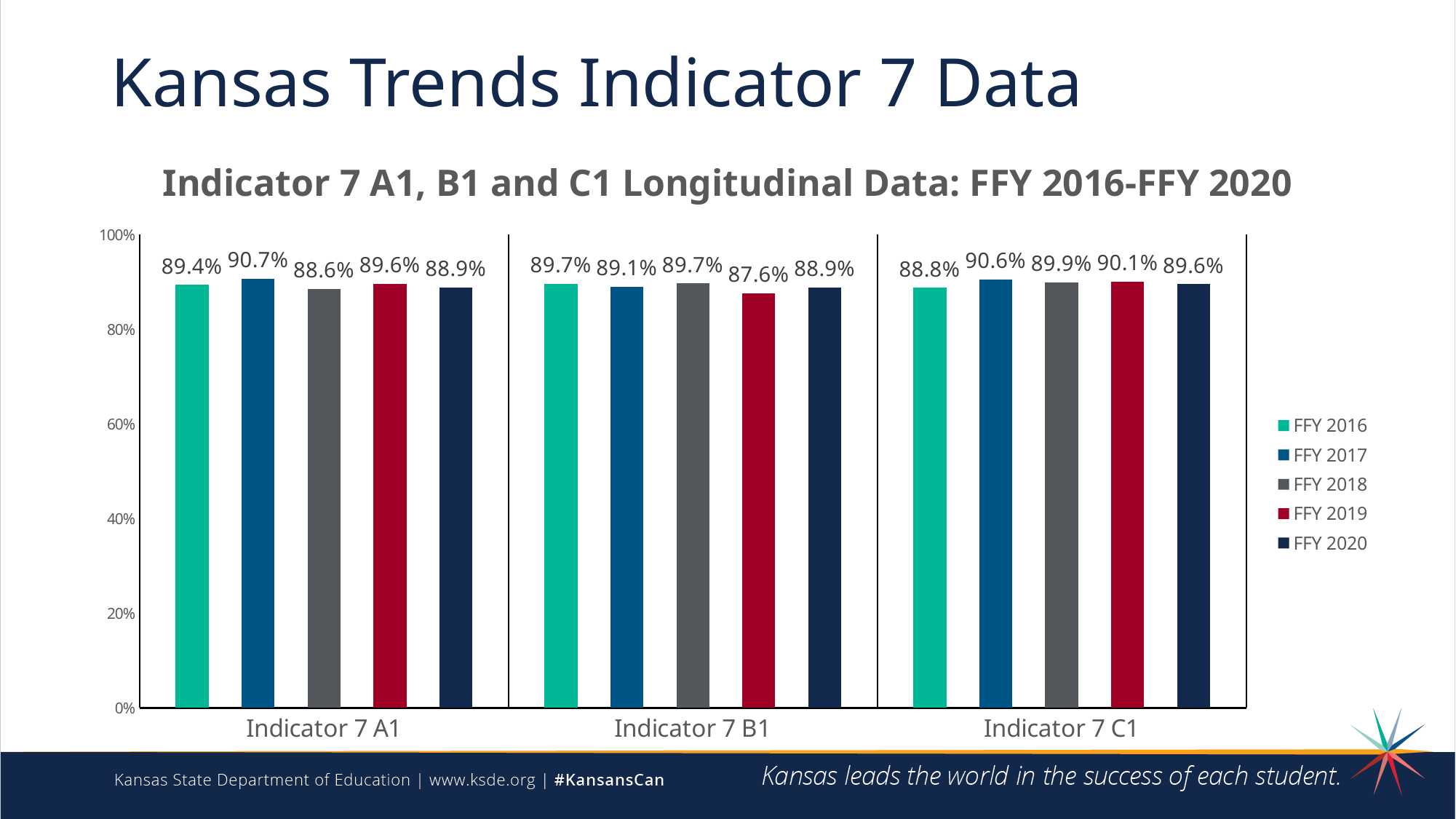
What is the value for FFY 2020 for Indicator 7 C1? 89.6% How many series does the legend list? 5 How many indicator categories are shown on the x axis? 3 Which year has the highest value for Indicator 7 A1? FFY 2017 Which is larger for Indicator 7 C1: the FFY 2018 value or the FFY 2019 value? FFY 2019 What is the value for FFY 2019 for Indicator 7 B1? 87.6% What is the difference between the FFY 2017 and FFY 2018 values for Indicator 7 A1? 2.1% What is the value for FFY 2016 for Indicator 7 C1? 88.8% Which year has the lowest value for Indicator 7 B1? FFY 2019 What kind of chart is shown on the slide? Bar chart What is the value for FFY 2017 for Indicator 7 A1? 90.7% Is the value for FFY 2016 for Indicator 7 B1 greater or less than 80%? greater